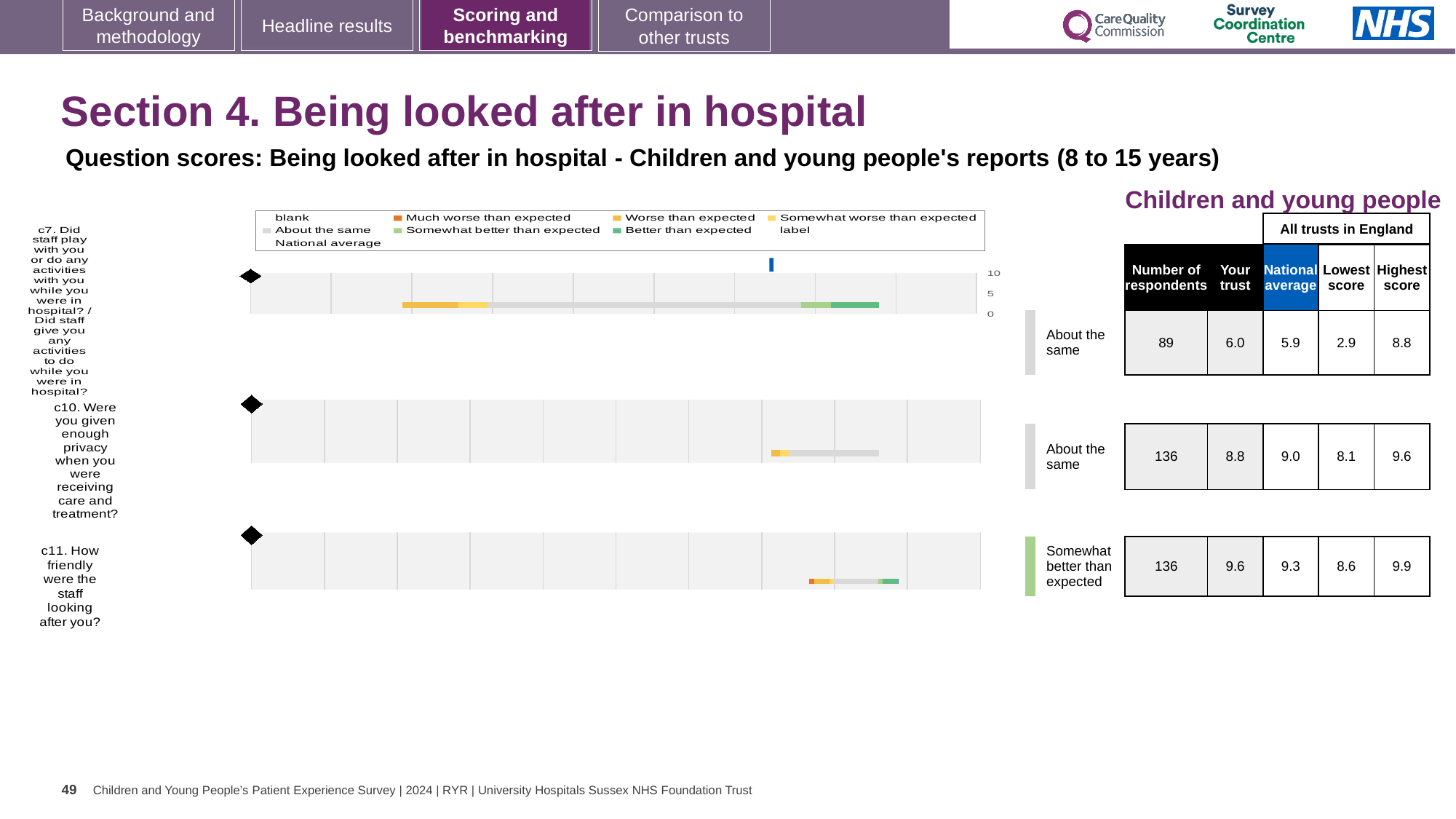
What is the 'Your trust' score for question c11 (How friendly were the staff looking after you?)? 9.6 Which question has the highest 'Your trust' score? c11 What kind of chart is used to show the question scores? Bar chart What is the lowest score across all trusts in England for question c7? 2.9 What benchmark category is shown for question c11? Somewhat better than expected For question c7, how much higher is the 'Your trust' score than the national average? 0.1 What is the national average score for question c10 (Were you given enough privacy when you were receiving care and treatment?)? 9.0 For question c11, what is the difference between the highest score and the lowest score across all trusts in England? 1.3 For question c10, which is larger: the 'Your trust' score or the national average? National average How many questions are plotted on this slide? 3 Which question has the lowest 'Your trust' score? c7 How many respondents answered question c7 (Did staff play with you or do any activities with you while you were in hospital?)? 89